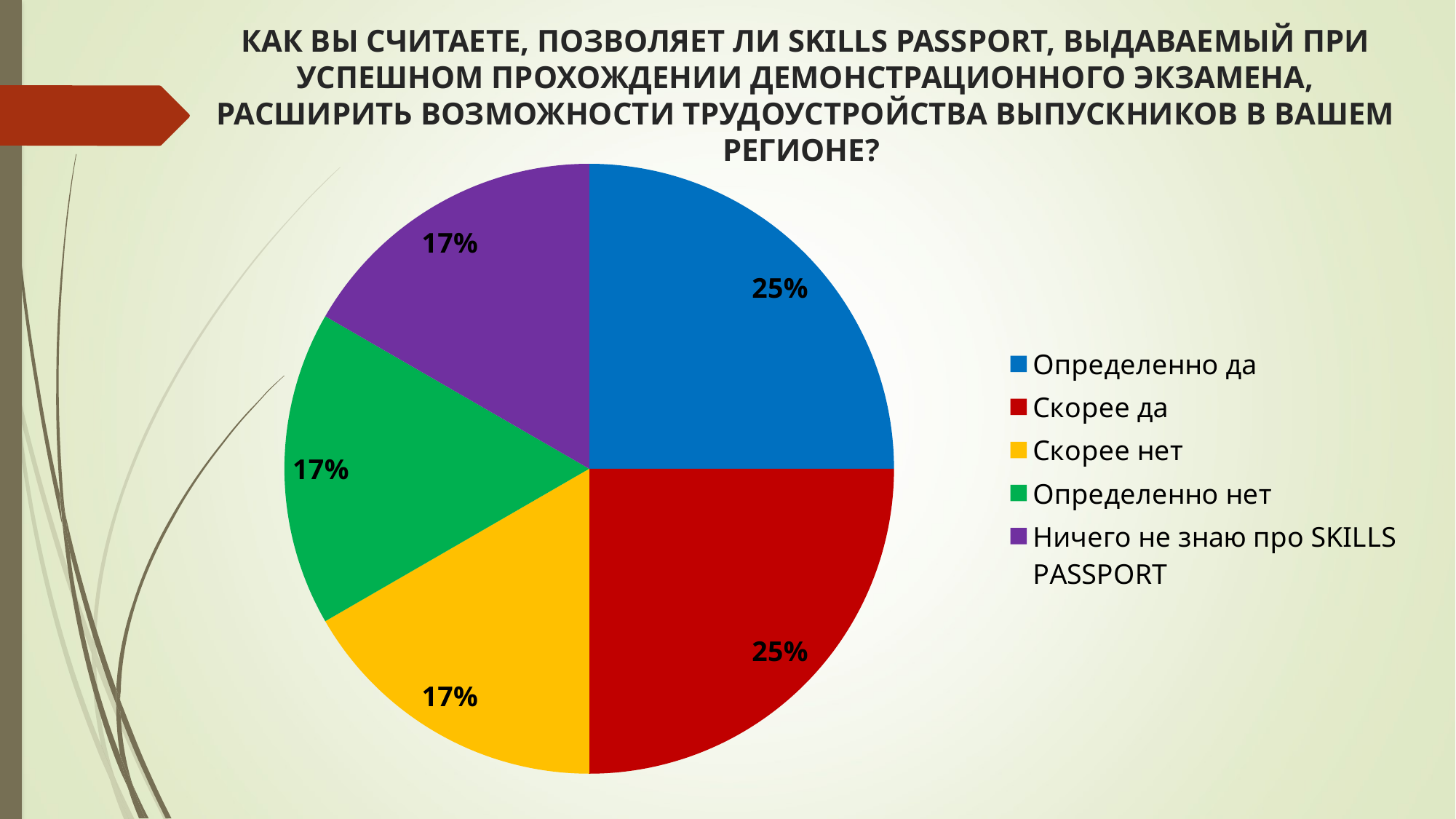
What share of the pie is labelled "Определенно нет"? 17% What share of the pie is labelled "Определенно да"? 25% What share of the pie is labelled "Скорее да"? 25% What colour is the slice for "Ничего не знаю про SKILLS PASSPORT"? purple Which is larger: the share for "Определенно да" or the share for "Скорее нет"? Определенно да How many entries does the legend list? 5 What is the difference in percentage points between the "Скорее да" slice and the "Определенно нет" slice? 8 Which legend entry is shown in green? Определенно нет How many slices does the pie chart have? 5 What kind of chart is shown on the slide? pie chart